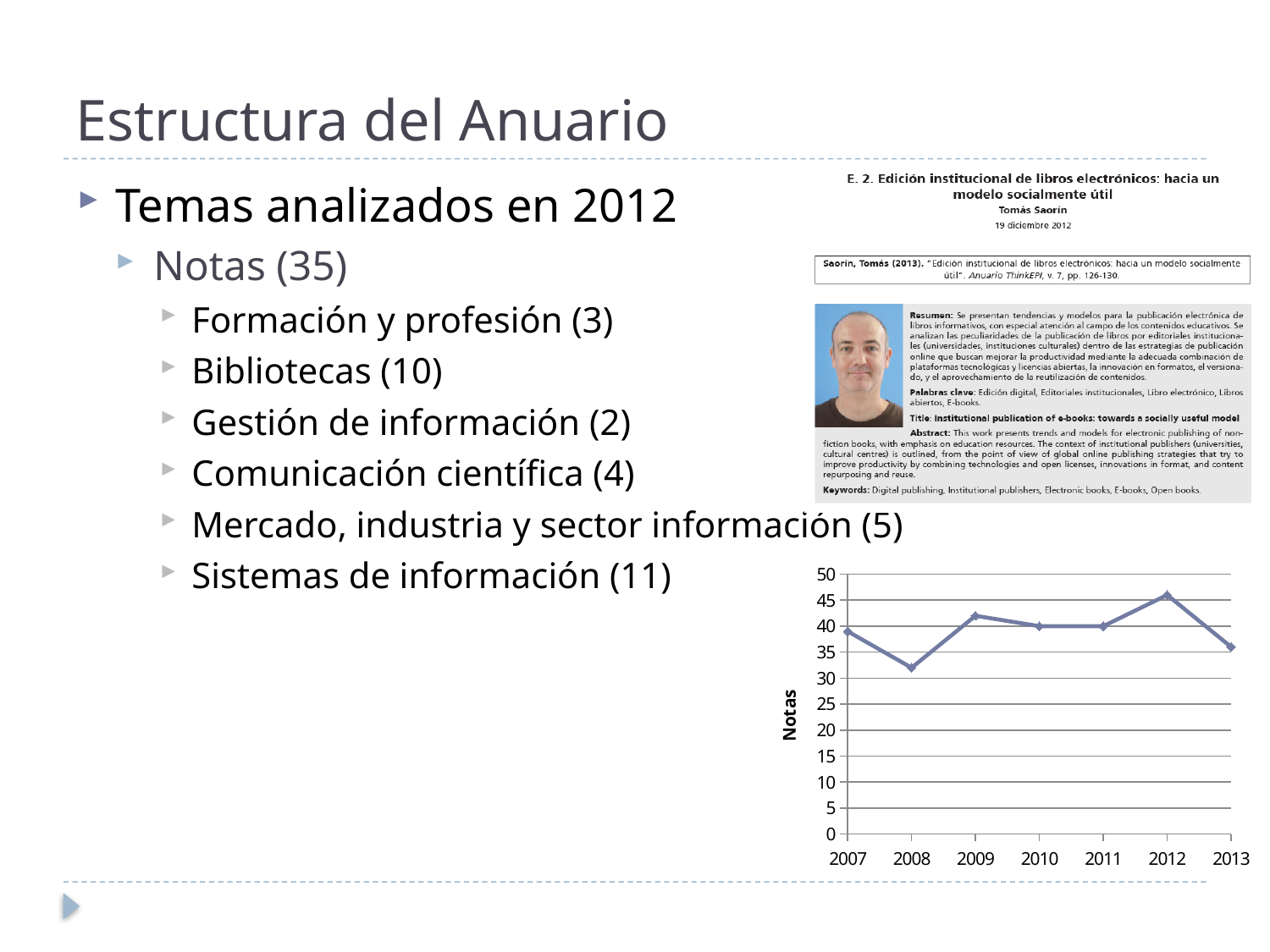
What kind of chart is shown on the slide? line chart Which year has more Notas, 2008 or 2009? 2009 Is the value for 2008 greater or less than 35? less Which year has the highest number of Notas in the chart? 2012 Does the number of Notas rise or fall from 2012 to 2013? fall How many years are plotted on the x axis of the chart? 7 What is the label on the y axis of the chart? Notas Does the number of Notas rise or fall from 2008 to 2009? rise Is the value for 2007 greater or less than 35? greater Is the value for 2013 greater or less than 40? less Which year has the lowest number of Notas in the chart? 2008